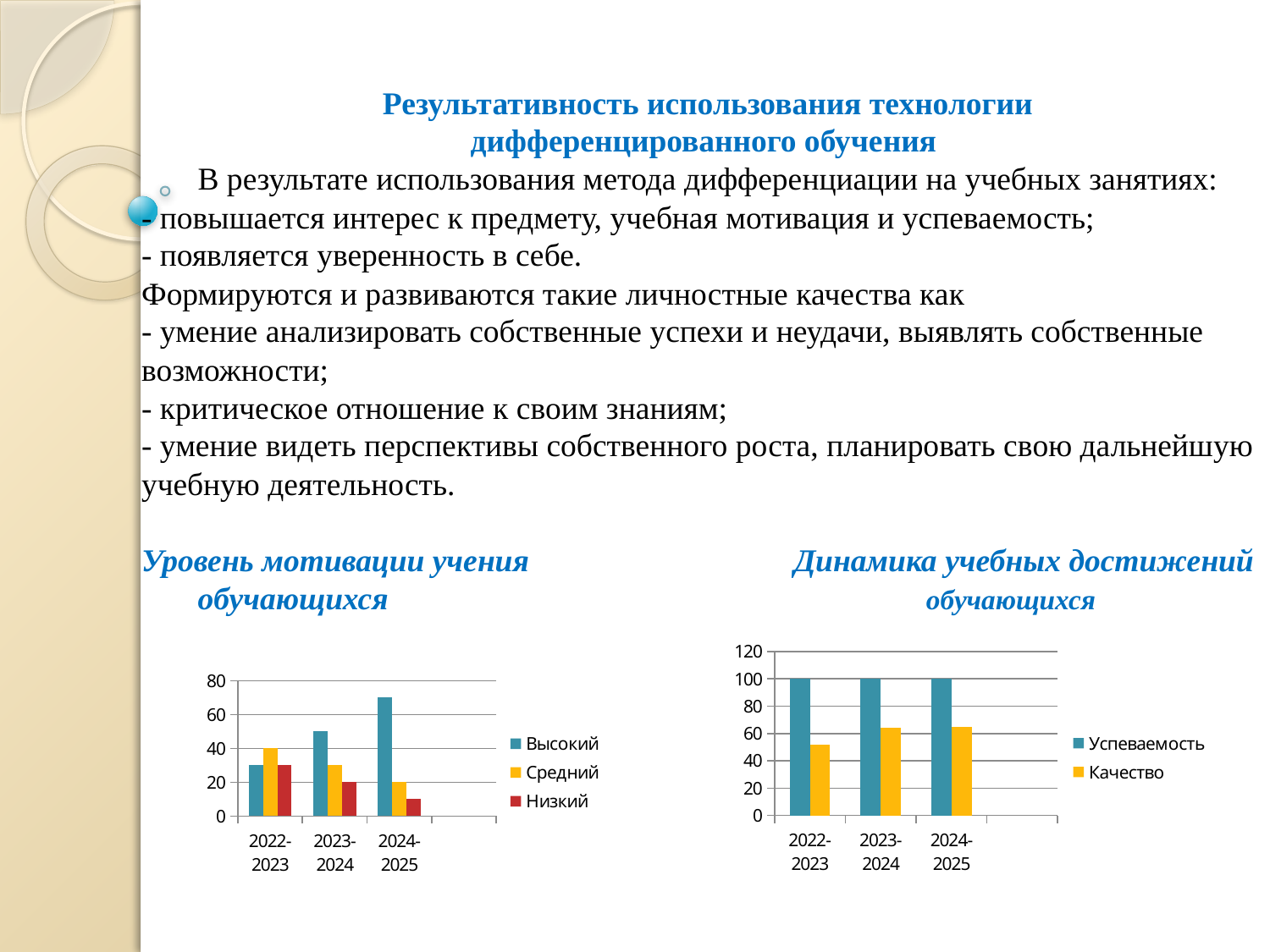
On the chart titled "Динамика учебных достижений обучающихся", which series is larger in 2023-2024: "Успеваемость" or "Качество"? Успеваемость On the chart titled "Уровень мотивации учения обучающихся", which series has the highest value in 2024-2025? Высокий On the chart titled "Динамика учебных достижений обучающихся", how many series does the legend list? 2 On the chart titled "Динамика учебных достижений обучающихся", is the value for "Качество" in 2022-2023 greater or less than 60? less On the chart titled "Уровень мотивации учения обучающихся", what kind of chart is shown? bar chart On the chart titled "Уровень мотивации учения обучающихся", is the value for "Низкий" in 2024-2025 greater or less than 20? less On the chart titled "Уровень мотивации учения обучающихся", how many series does the legend list? 3 On the chart titled "Уровень мотивации учения обучающихся", how many academic-year categories are shown on the x axis? 3 On the chart titled "Динамика учебных достижений обучающихся", what is the value of "Успеваемость" for 2022-2023? 100 On the chart titled "Уровень мотивации учения обучающихся", does the "Высокий" series rise or fall from 2022-2023 to 2024-2025? rise On the chart titled "Уровень мотивации учения обучающихся", is the value for "Высокий" in 2024-2025 greater or less than 60? greater On the chart titled "Уровень мотивации учения обучающихся", which is larger in 2022-2023: "Высокий" or "Средний"? Средний